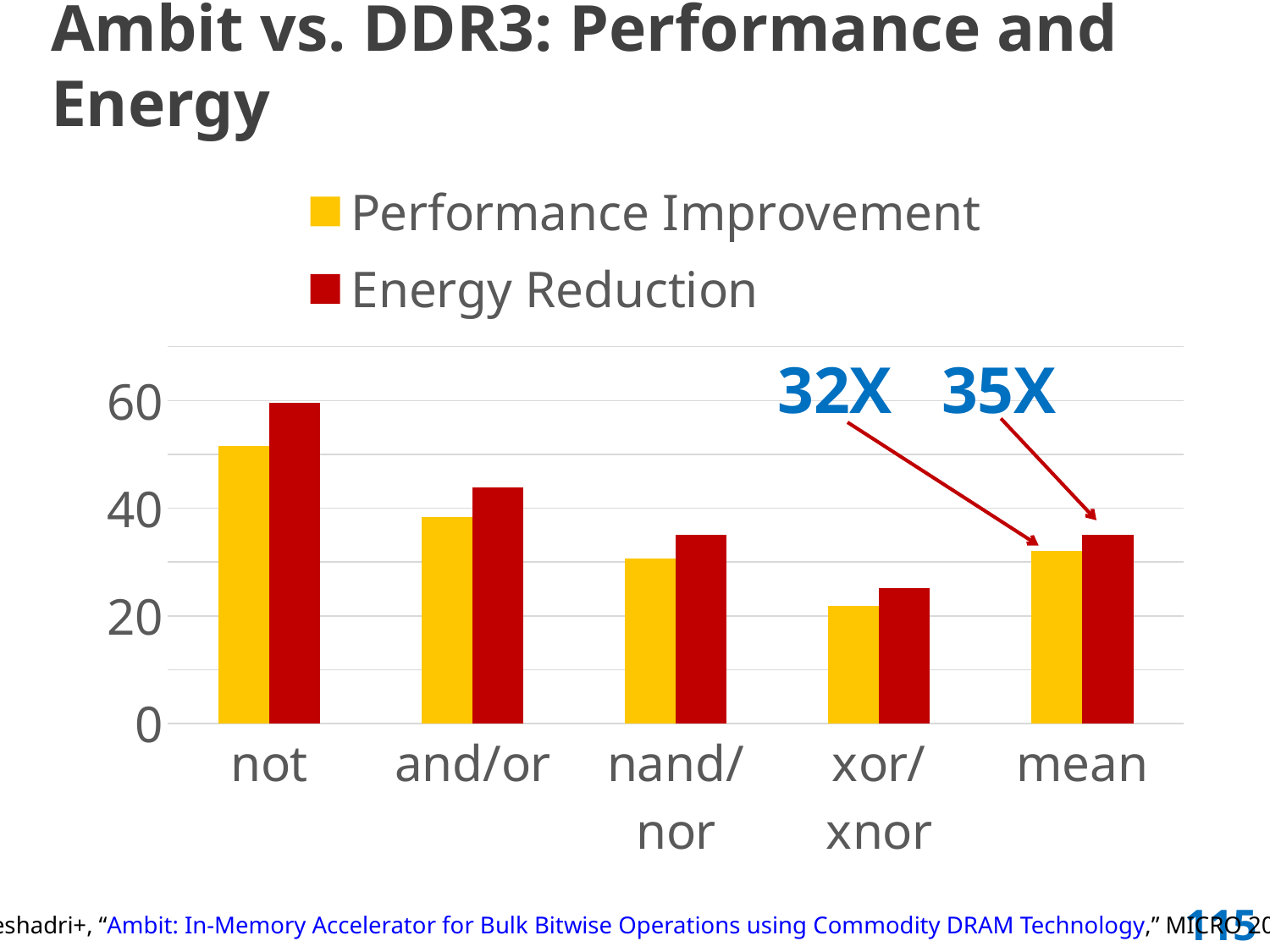
Which category has the highest Energy Reduction bar? not What kind of chart is shown on the slide? bar chart What is the Energy Reduction value for the mean category? 35X Is the Performance Improvement value for xor/xnor greater or less than 40? less For the mean category, what is the difference between the Energy Reduction and the Performance Improvement values? 3X What is the Performance Improvement value for the mean category? 32X How many categories are shown on the x axis? 5 How many series does the legend list? 2 For the not category, which is larger: Performance Improvement or Energy Reduction? Energy Reduction Is the Energy Reduction value for not greater or less than 40? greater Which category has the lowest Performance Improvement bar? xor/xnor Which colour represents Energy Reduction in the legend? red